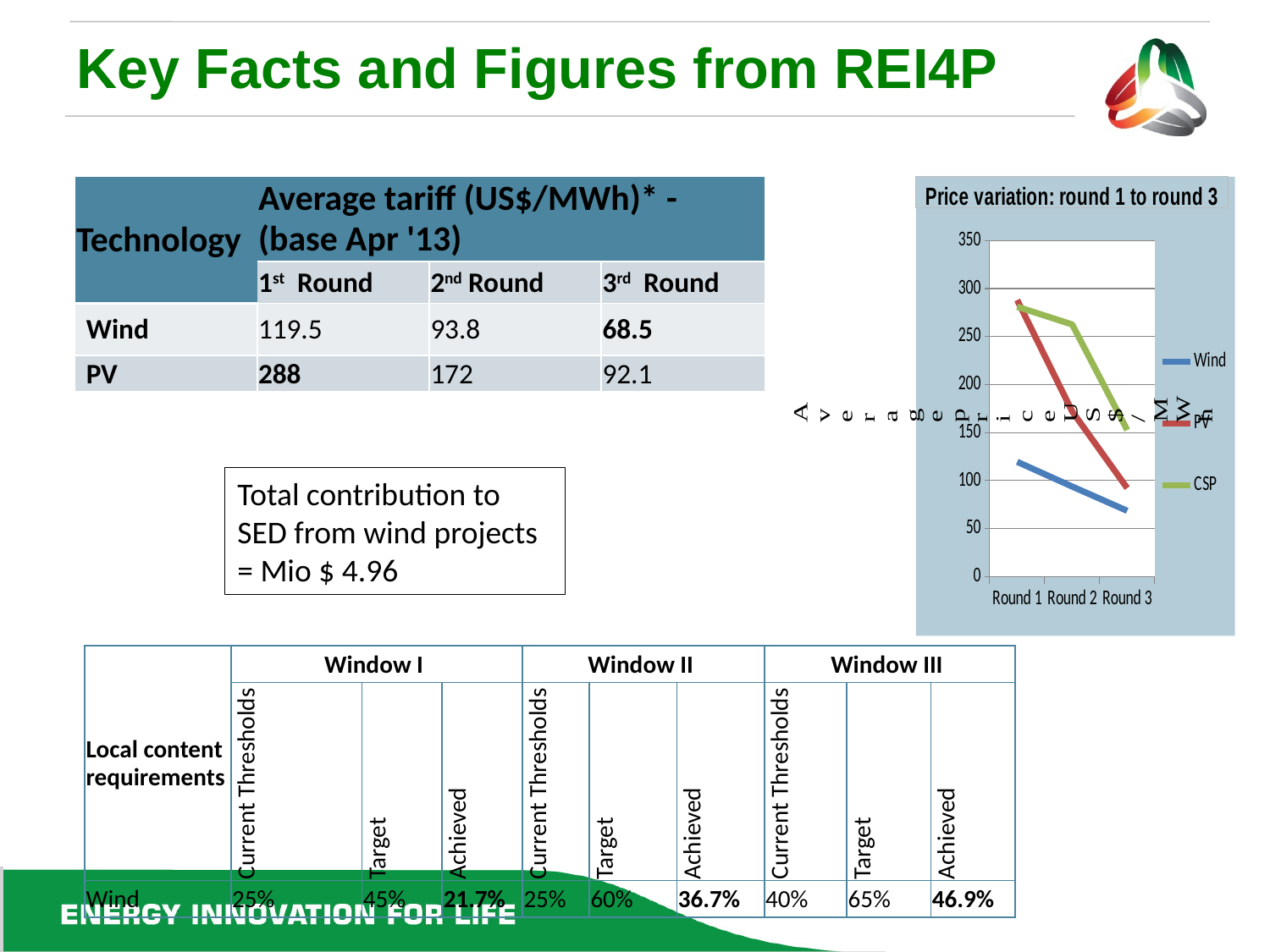
In the "Price variation: round 1 to round 3" chart, does the Wind line rise or fall from Round 1 to Round 3? fall In the "Price variation: round 1 to round 3" chart, is the value for PV at Round 1 greater or less than 250? greater What kind of chart is the "Price variation: round 1 to round 3" chart? line chart In the "Price variation: round 1 to round 3" chart, is the value for Wind at Round 1 greater or less than 150? less How many series does the legend of the "Price variation: round 1 to round 3" chart list? 3 What colour is the Wind line in the "Price variation: round 1 to round 3" chart? blue In the "Price variation: round 1 to round 3" chart, is the value for CSP at Round 3 greater or less than 100? greater In the "Price variation: round 1 to round 3" chart, does the PV line rise or fall from Round 1 to Round 3? fall In the "Price variation: round 1 to round 3" chart, which series has the lowest value at Round 1? Wind How many rounds are shown on the x axis of the "Price variation: round 1 to round 3" chart? 3 In the "Price variation: round 1 to round 3" chart, which is higher at Round 3, PV or CSP? CSP In the "Price variation: round 1 to round 3" chart, which series has the highest value at Round 3? CSP